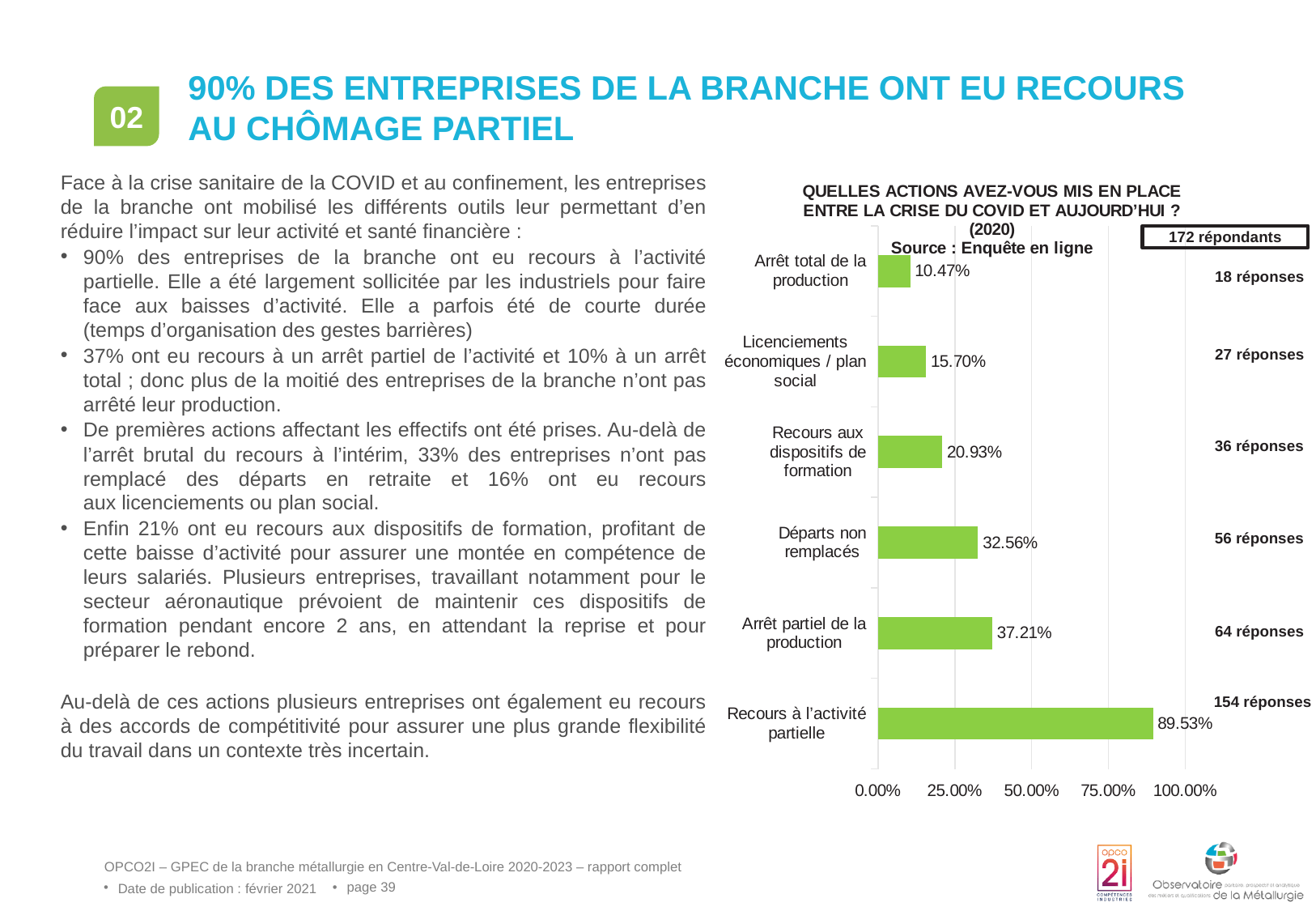
What is the difference in percentage points between "Arrêt partiel de la production" and "Arrêt total de la production"? 26.74 Which category has the lowest percentage in the chart? Arrêt total de la production What percentage is shown for "Recours à l'activité partielle"? 89.53% How many respondents does the chart indicate in the box at the top right? 172 répondants Which is larger: the percentage for "Recours aux dispositifs de formation" or for "Départs non remplacés"? Départs non remplacés What percentage is shown for "Licenciements économiques / plan social"? 15.70% Is the value for "Arrêt partiel de la production" greater or less than 50.00%? less What kind of chart is shown on the slide? Bar chart Which category has the highest percentage in the chart? Recours à l'activité partielle What percentage is shown for "Départs non remplacés"? 32.56% How many categories are plotted in the chart? 6 What percentage is shown for "Arrêt total de la production"? 10.47%